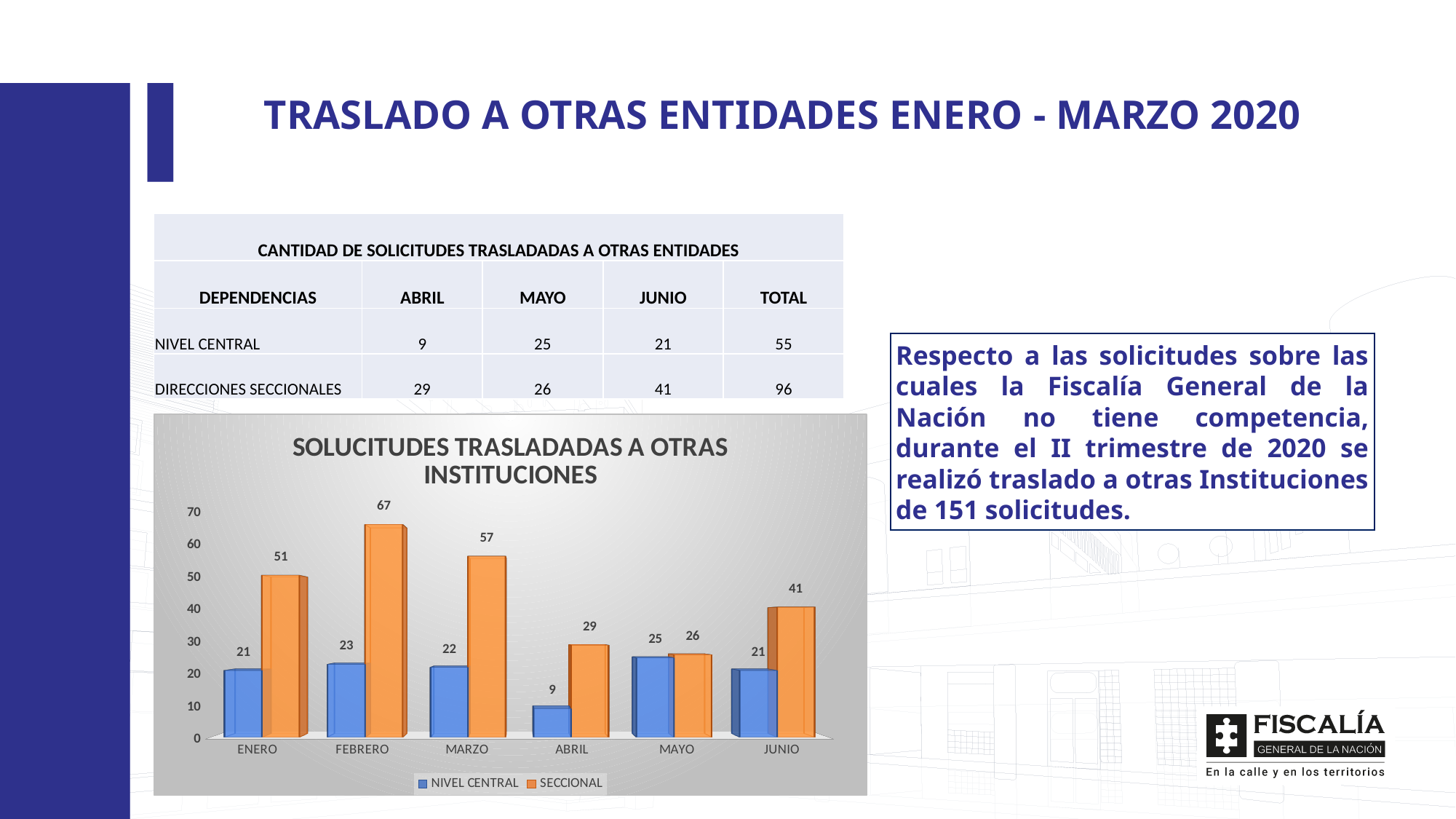
How many series does the chart legend list? 2 What colour are the SECCIONAL bars in the chart? Orange Which is larger in the chart: the SECCIONAL value for ENERO or the SECCIONAL value for JUNIO? SECCIONAL value for ENERO Which month has the highest SECCIONAL value in the chart? FEBRERO What is the SECCIONAL value for JUNIO in the chart? 41 What is the title of the chart? SOLUCITUDES TRASLADADAS A OTRAS INSTITUCIONES What is the NIVEL CENTRAL value for ABRIL in the chart? 9 How many months are shown on the x axis of the chart? 6 What is the difference between the SECCIONAL and NIVEL CENTRAL values for MARZO in the chart? 35 What kind of chart is shown on the slide? Bar chart What is the SECCIONAL value for FEBRERO in the chart? 67 Which month has the lowest NIVEL CENTRAL value in the chart? ABRIL